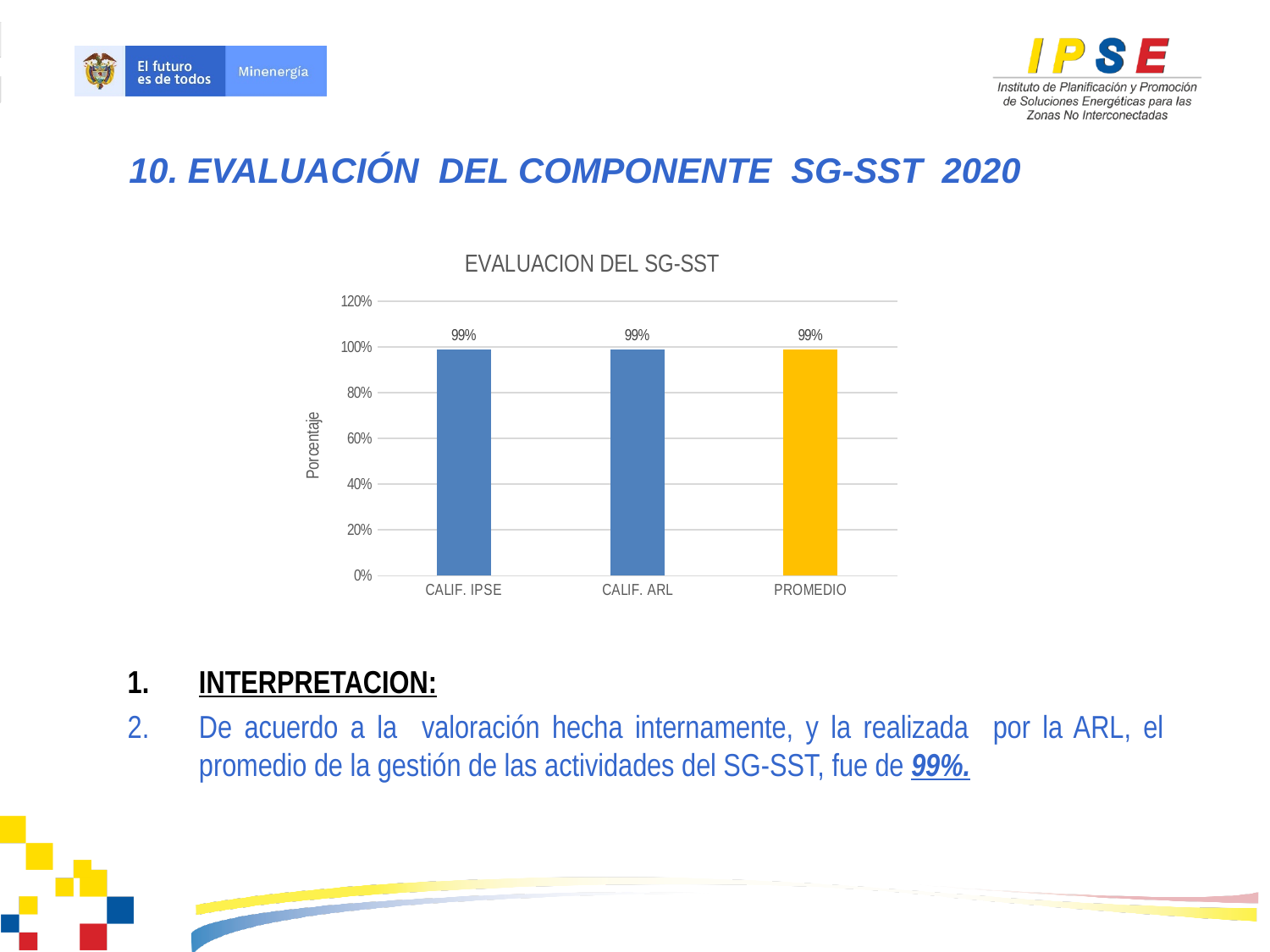
What is the difference between the values for CALIF. IPSE and CALIF. ARL? 0% What kind of chart is shown? bar chart What is the value for PROMEDIO? 99% Is the value for PROMEDIO greater or less than 80%? greater How many categories are shown on the x axis? 3 What is the value for CALIF. ARL? 99% What is the value for CALIF. IPSE? 99% What is the title of the chart? EVALUACION DEL SG-SST What is the label of the y axis? Porcentaje Do the values rise, fall or stay the same across the categories from left to right? stay the same Is the value for CALIF. IPSE greater or less than 100%? less